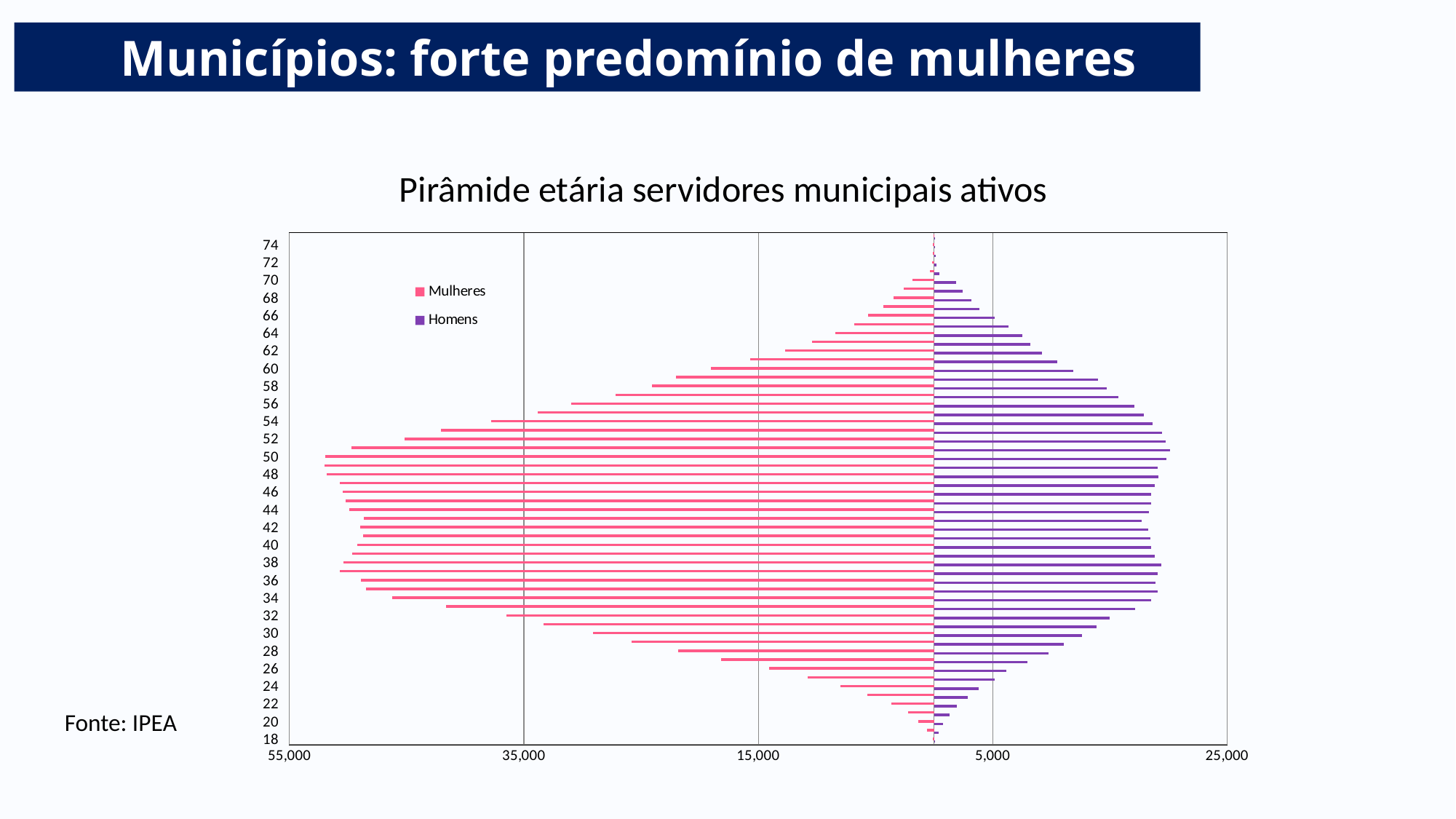
Which series is shown in pink in the chart? Mulheres Do the Mulheres values rise or fall as age increases from 50 to 74? fall How many series does the legend list? 2 Is the value for Mulheres at age 62 greater or less than 15,000? less What kind of chart is shown on the slide? Bar chart For Mulheres, which age has the larger value, 40 or 60? 40 Is the value for Mulheres at age 50 greater or less than 35,000? greater Is the value for Homens at age 20 greater or less than 5,000? less At age 50, which series has the larger value, Mulheres or Homens? Mulheres For Homens, which age has the larger value, 40 or 70? 40 What is the title of the chart? Pirâmide etária servidores municipais ativos